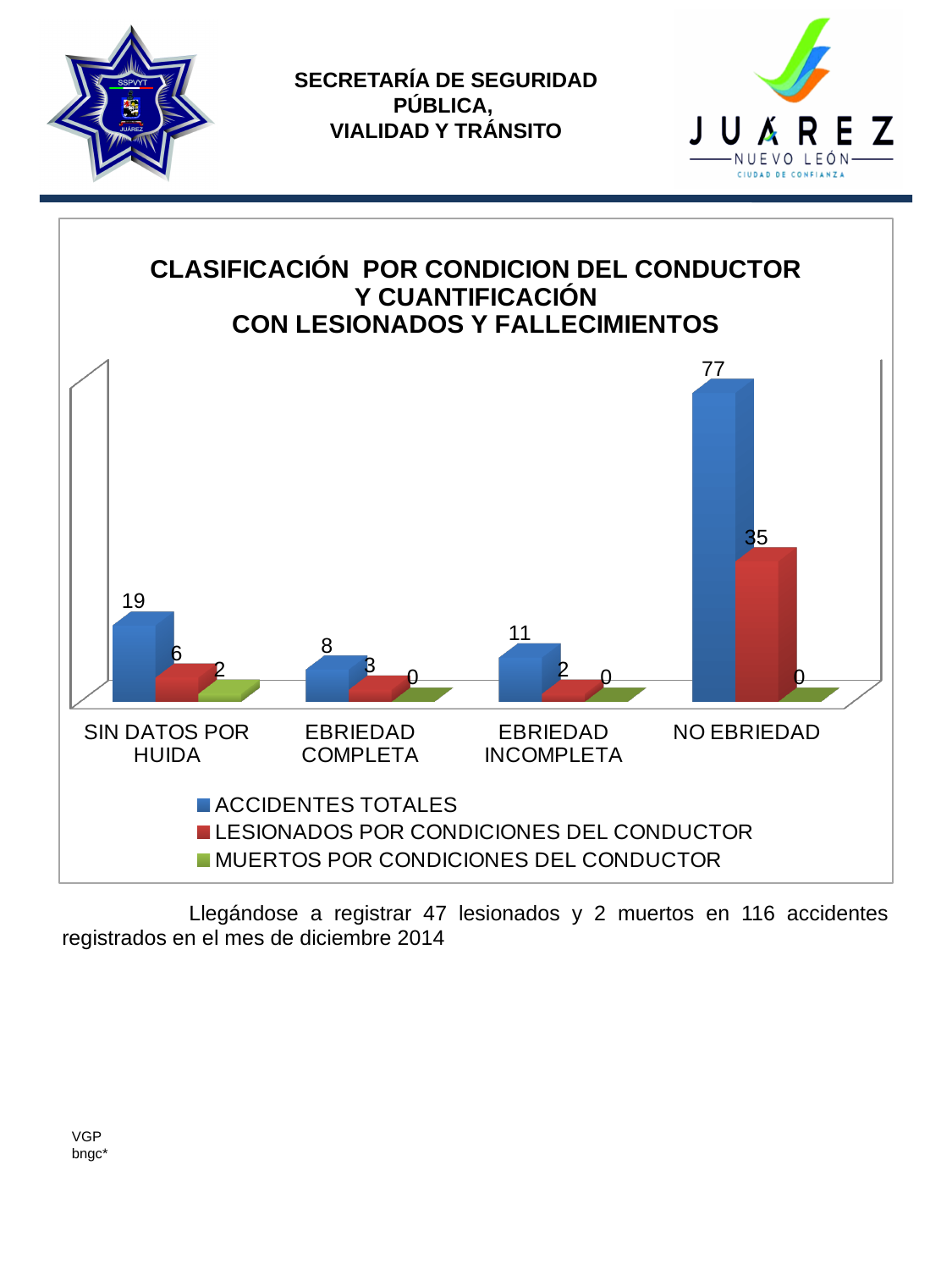
What is the value of ACCIDENTES TOTALES for NO EBRIEDAD? 77 What is the difference between ACCIDENTES TOTALES for NO EBRIEDAD and for SIN DATOS POR HUIDA? 58 Which category has the lowest value for ACCIDENTES TOTALES? EBRIEDAD COMPLETA What is the value of MUERTOS POR CONDICIONES DEL CONDUCTOR for EBRIEDAD COMPLETA? 0 How many categories are shown on the x axis? 4 What is the value of LESIONADOS POR CONDICIONES DEL CONDUCTOR for SIN DATOS POR HUIDA? 6 Which category has the highest value for ACCIDENTES TOTALES? NO EBRIEDAD What kind of chart is shown on the slide? Bar chart What is the value of ACCIDENTES TOTALES for EBRIEDAD INCOMPLETA? 11 Which is larger: LESIONADOS POR CONDICIONES DEL CONDUCTOR for SIN DATOS POR HUIDA or for EBRIEDAD COMPLETA? SIN DATOS POR HUIDA How many series does the legend list? 3 Which series is shown in green in the legend? MUERTOS POR CONDICIONES DEL CONDUCTOR